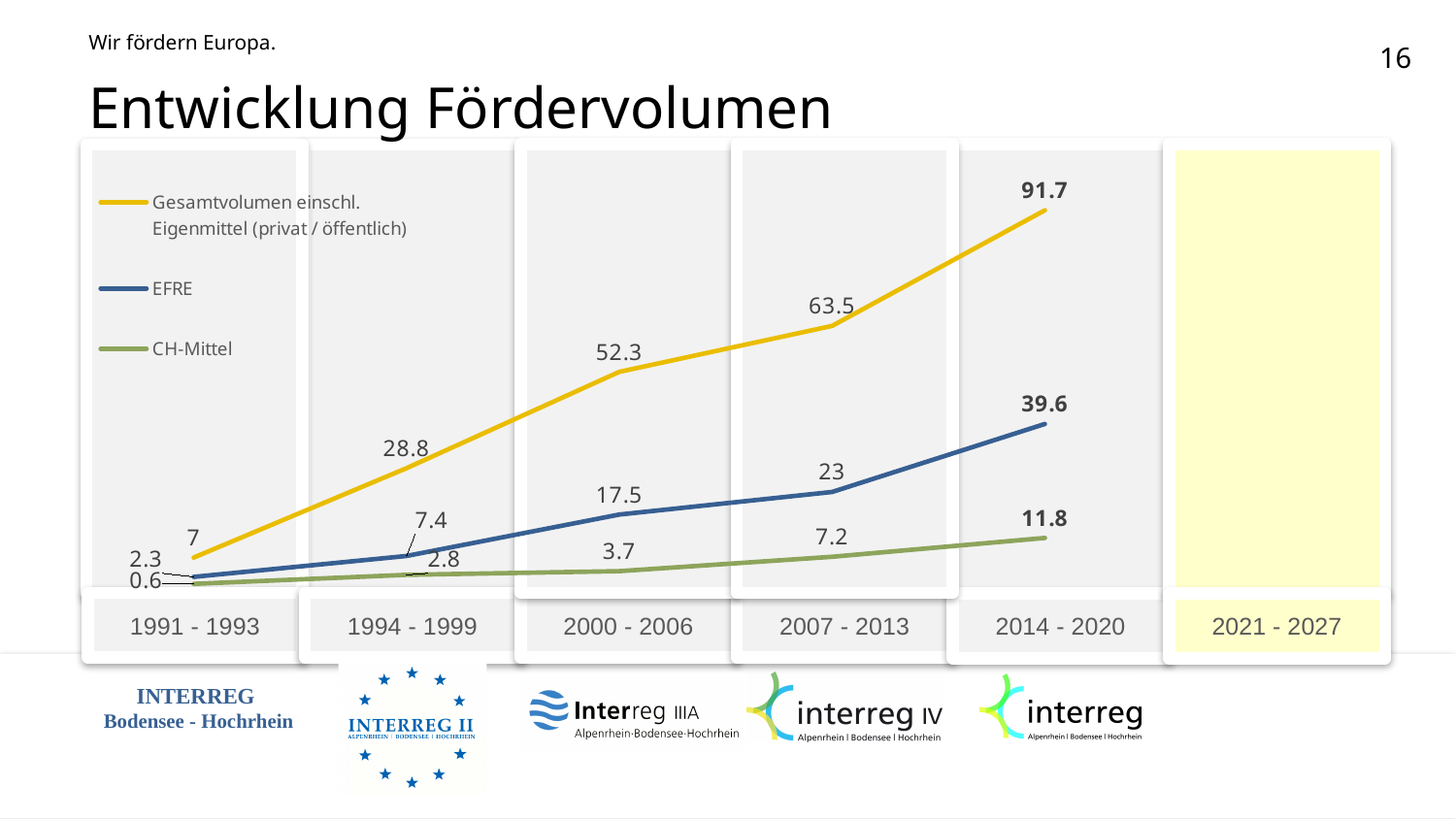
How many periods have data values plotted on the chart? 5 In which period is the CH-Mittel value lowest? 1991 - 1993 In which period is the Gesamtvolumen einschl. Eigenmittel value highest? 2014 - 2020 How many series does the legend list? 3 What is the value of Gesamtvolumen einschl. Eigenmittel for 2014 - 2020? 91.7 What is the EFRE value for 1991 - 1993? 2.3 Which is larger in 1994 - 1999: the EFRE value or the CH-Mittel value? EFRE What is the EFRE value for 2000 - 2006? 17.5 What is the difference between the EFRE values for 2014 - 2020 and 2007 - 2013? 16.6 What type of chart is shown on the slide? line chart Does the Gesamtvolumen einschl. Eigenmittel series rise or fall from 1991 - 1993 to 2014 - 2020? rise What is the CH-Mittel value for 2007 - 2013? 7.2